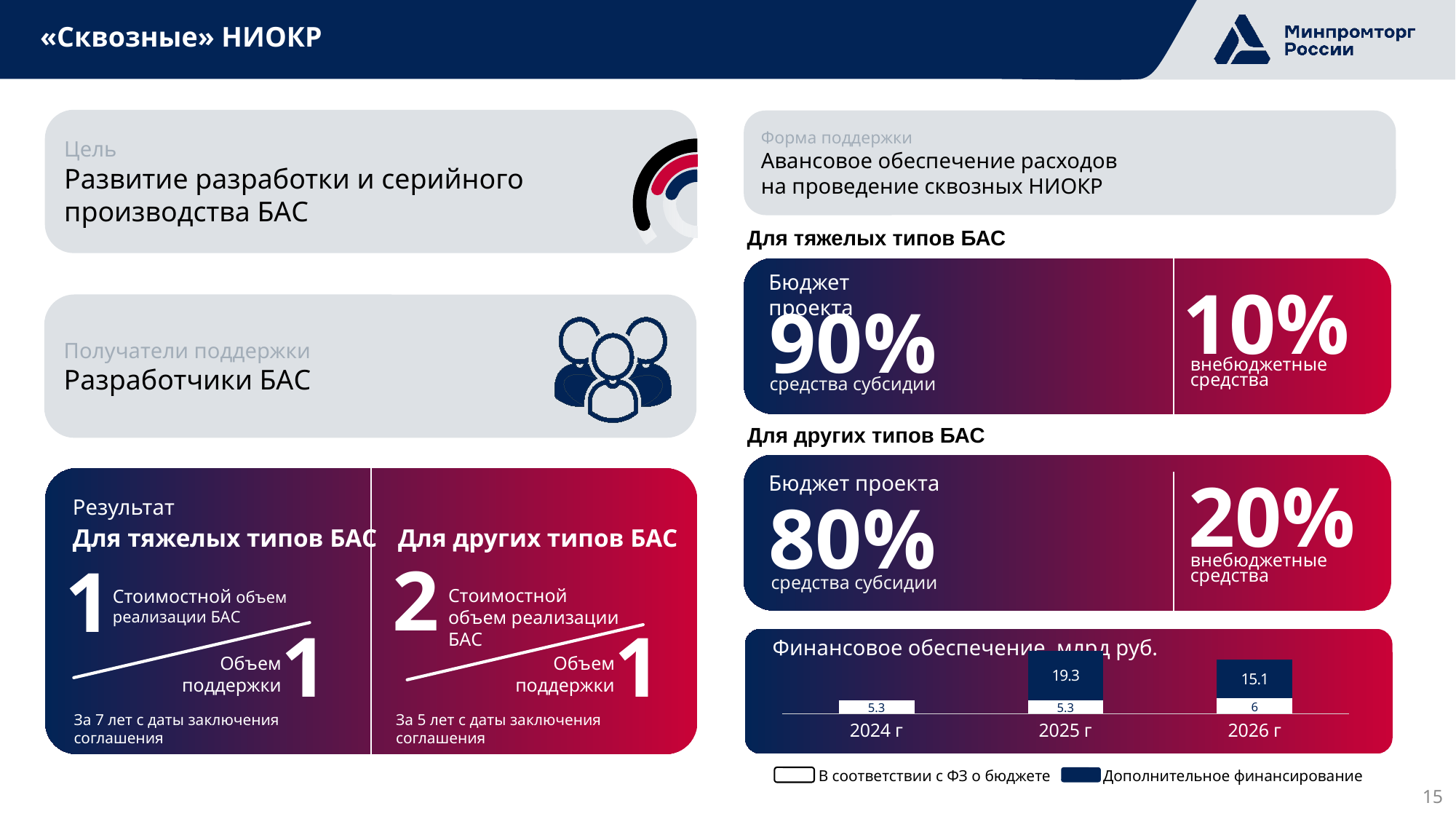
How many years are shown on the x axis of the "Финансовое обеспечение, млрд руб." chart? 3 In the "Финансовое обеспечение, млрд руб." chart, what is the difference between the "Дополнительное финансирование" values for 2025 г and 2026 г? 4.2 In the "Финансовое обеспечение, млрд руб." chart, which year has the highest value for "Дополнительное финансирование"? 2025 г What type of chart is shown under the title "Финансовое обеспечение, млрд руб."? Stacked bar chart In the "Финансовое обеспечение, млрд руб." chart, is the "В соответствии с ФЗ о бюджете" value larger for 2024 г or 2026 г? 2026 г How many series does the legend of the "Финансовое обеспечение, млрд руб." chart list? 2 In the "Финансовое обеспечение, млрд руб." chart, what is the value of "В соответствии с ФЗ о бюджете" for 2024 г? 5.3 In the "Финансовое обеспечение, млрд руб." chart, what is the value of "Дополнительное финансирование" for 2025 г? 19.3 In the "Финансовое обеспечение, млрд руб." chart, what is the total of the stacked bar for 2025 г? 24.6 In the "Финансовое обеспечение, млрд руб." chart, what is the value of "В соответствии с ФЗ о бюджете" for 2026 г? 6 In the "Финансовое обеспечение, млрд руб." chart, what is the total of the stacked bar for 2026 г? 21.1 In the "Финансовое обеспечение, млрд руб." chart, what is the value of "Дополнительное финансирование" for 2026 г? 15.1